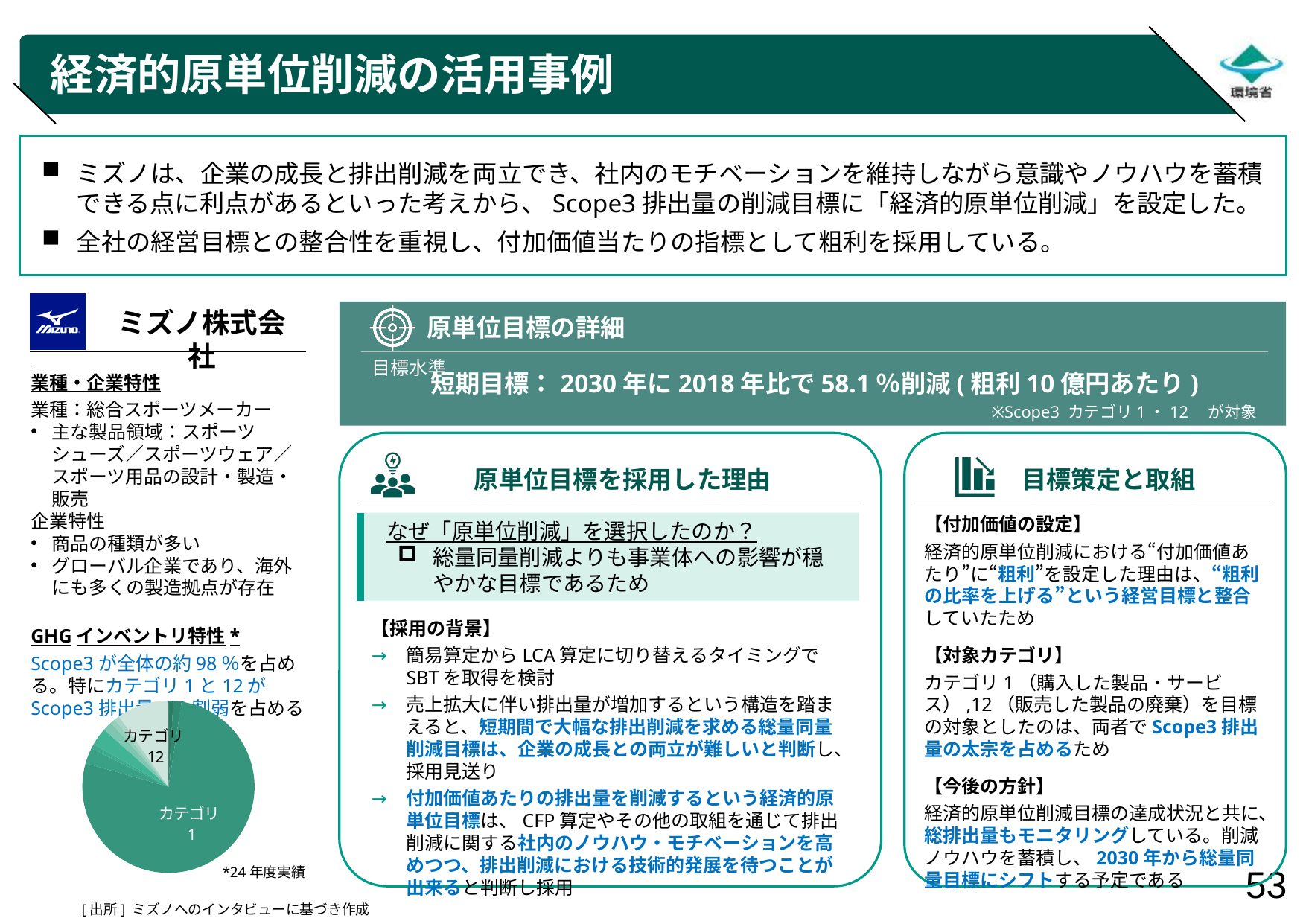
In the pie chart, which slice is larger, カテゴリ1 or カテゴリ12? カテゴリ1 What kind of chart is shown in the lower left of the slide under 'GHGインベントリ特性'? pie chart Which two category labels are printed on the pie chart? カテゴリ1 and カテゴリ12 In the pie chart, which category has the largest slice? カテゴリ1 According to the note next to the pie chart, which fiscal year's results does the chart show? 24年度実績